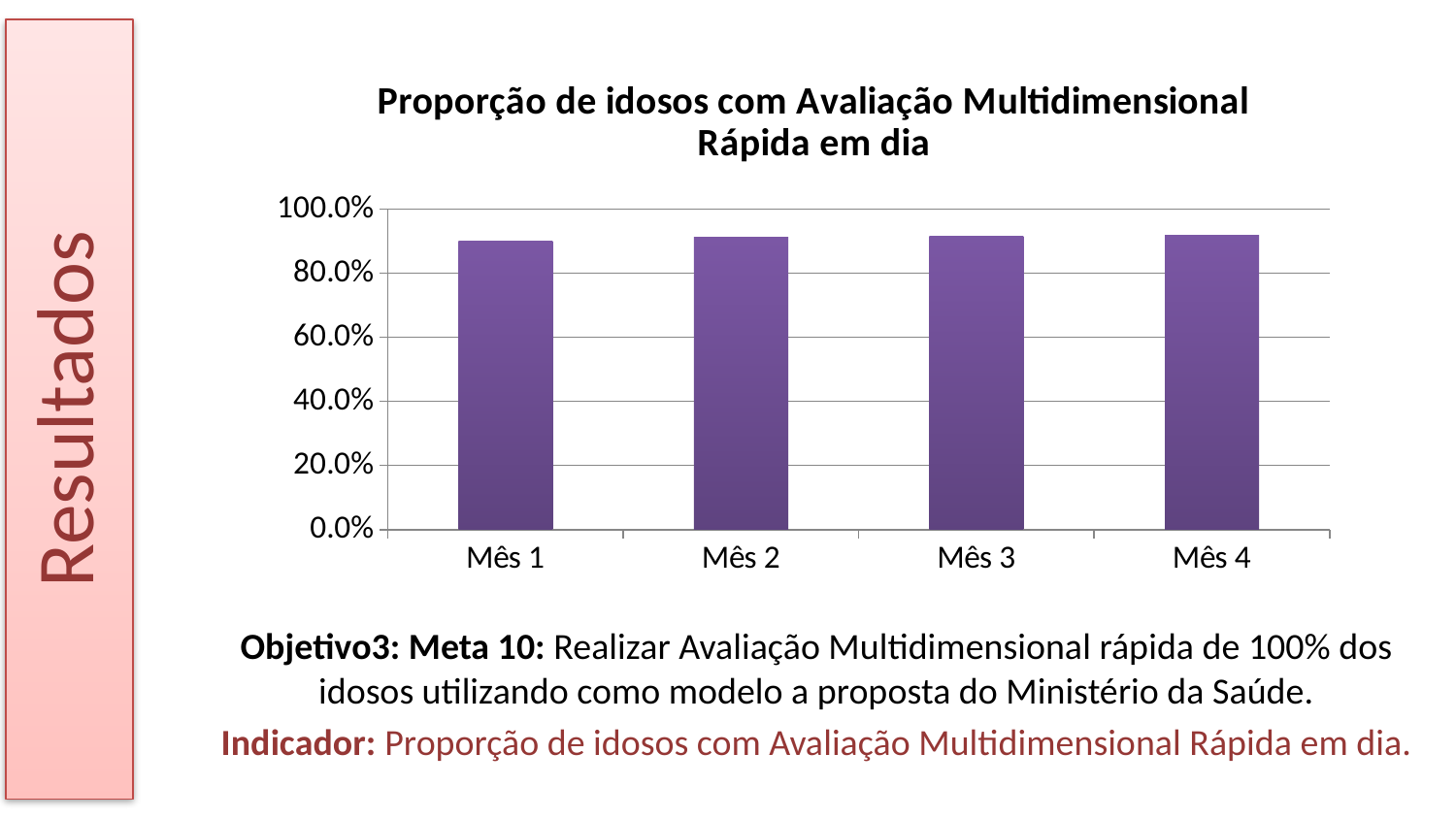
Is the value for Mês 1 greater or less than 80.0%? greater Is the value for Mês 2 greater or less than 100.0%? less What is the label of the first category on the x axis? Mês 1 Is the value for Mês 4 greater or less than 100.0%? less How many categories (months) are shown on the x axis of the chart? 4 What is the title of the chart? Proporção de idosos com Avaliação Multidimensional Rápida em dia What kind of chart is shown on the slide? bar chart What is the highest value shown on the y axis of the chart? 100.0%